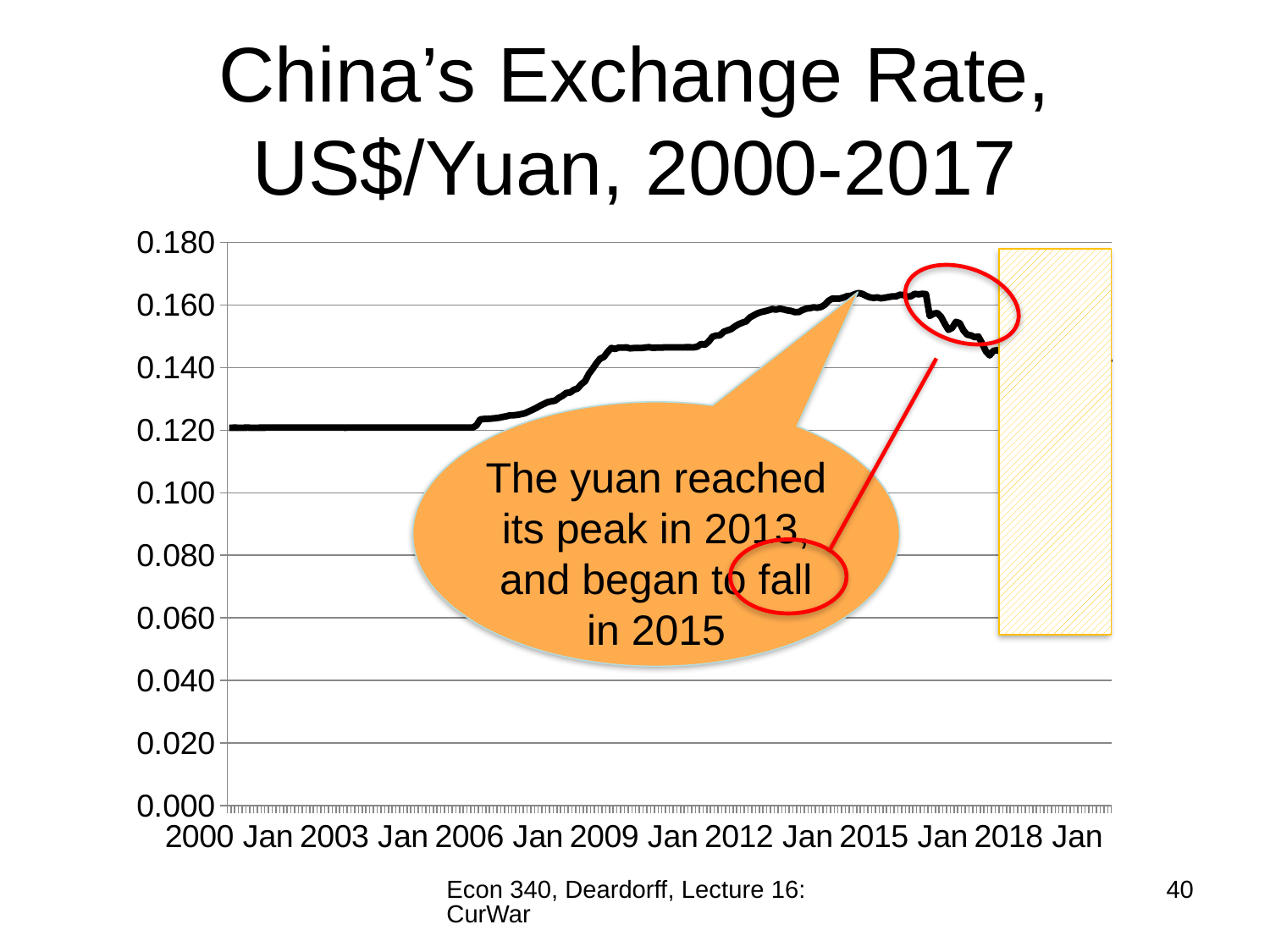
Which is larger, the exchange rate in 2003 Jan or in 2012 Jan? 2012 Jan According to the callout on the chart, in what year did the yuan reach its peak? 2013 How many data series (lines) are plotted on the chart? 1 Is the exchange rate in 2009 Jan greater or less than 0.120? greater What is the highest value shown on the vertical axis? 0.180 Is the exchange rate in 2000 Jan greater or less than 0.140? less What is the title of the chart? China's Exchange Rate, US$/Yuan, 2000-2017 Is the exchange rate in 2006 Jan greater or less than 0.140? less Does the exchange rate rise or fall between 2006 Jan and 2012 Jan? rise Does the exchange rate rise or fall between 2015 Jan and 2017? fall What kind of chart is shown on the slide? line chart